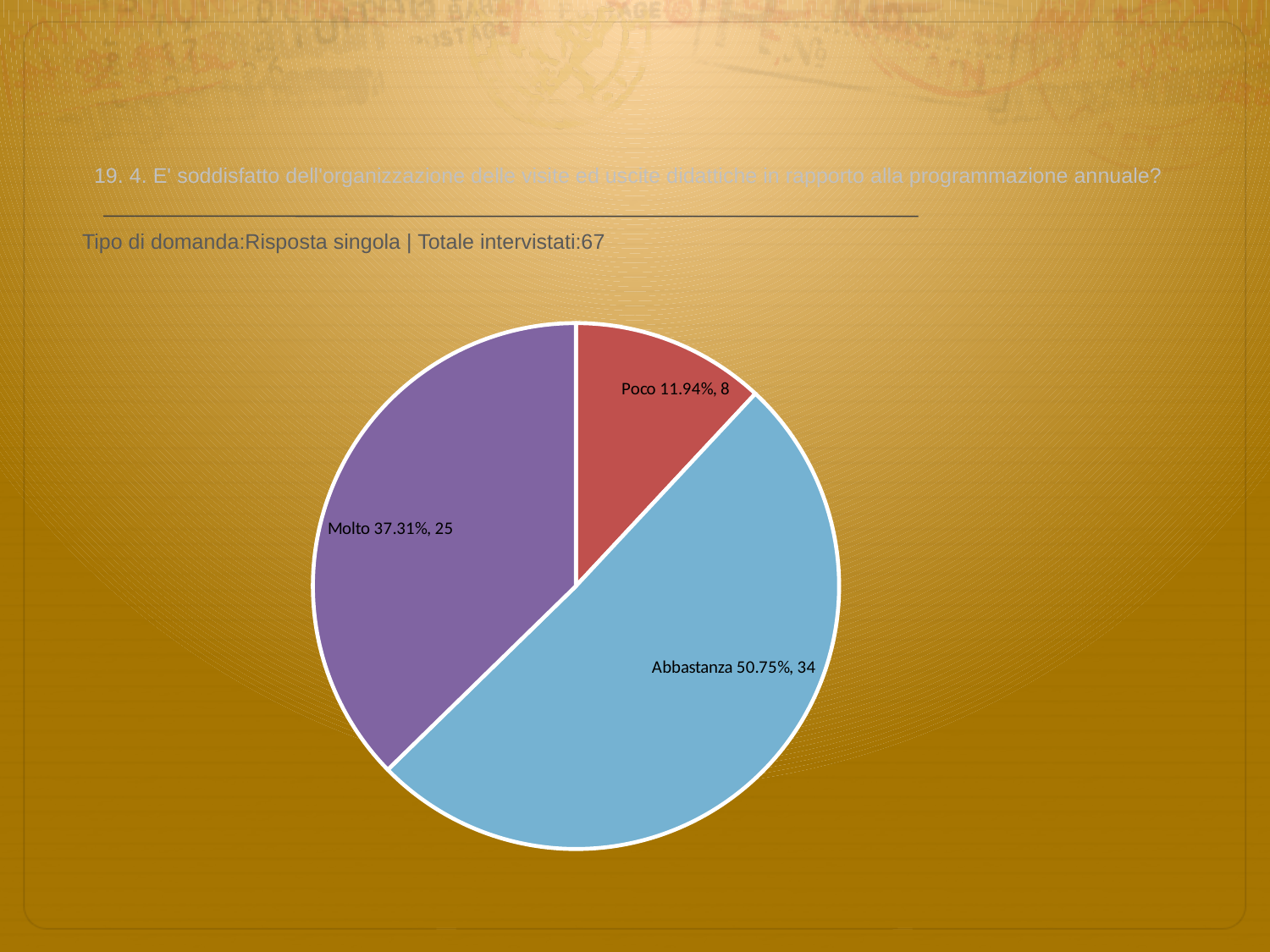
What colour is the Abbastanza slice? light blue What is the difference in count between Abbastanza and Molto? 9 How many slices does the pie chart have? 3 What percentage is shown for the Abbastanza slice? 50.75% What count is shown for the Molto slice? 25 What percentage is shown for the Poco slice? 11.94% Which slice is larger, Molto or Poco? Molto Which category has the smallest slice of the pie? Poco What is the difference in count between Molto and Poco? 17 What kind of chart is shown on the slide? pie chart Which category has the largest slice of the pie? Abbastanza What is the total count across all three slices? 67